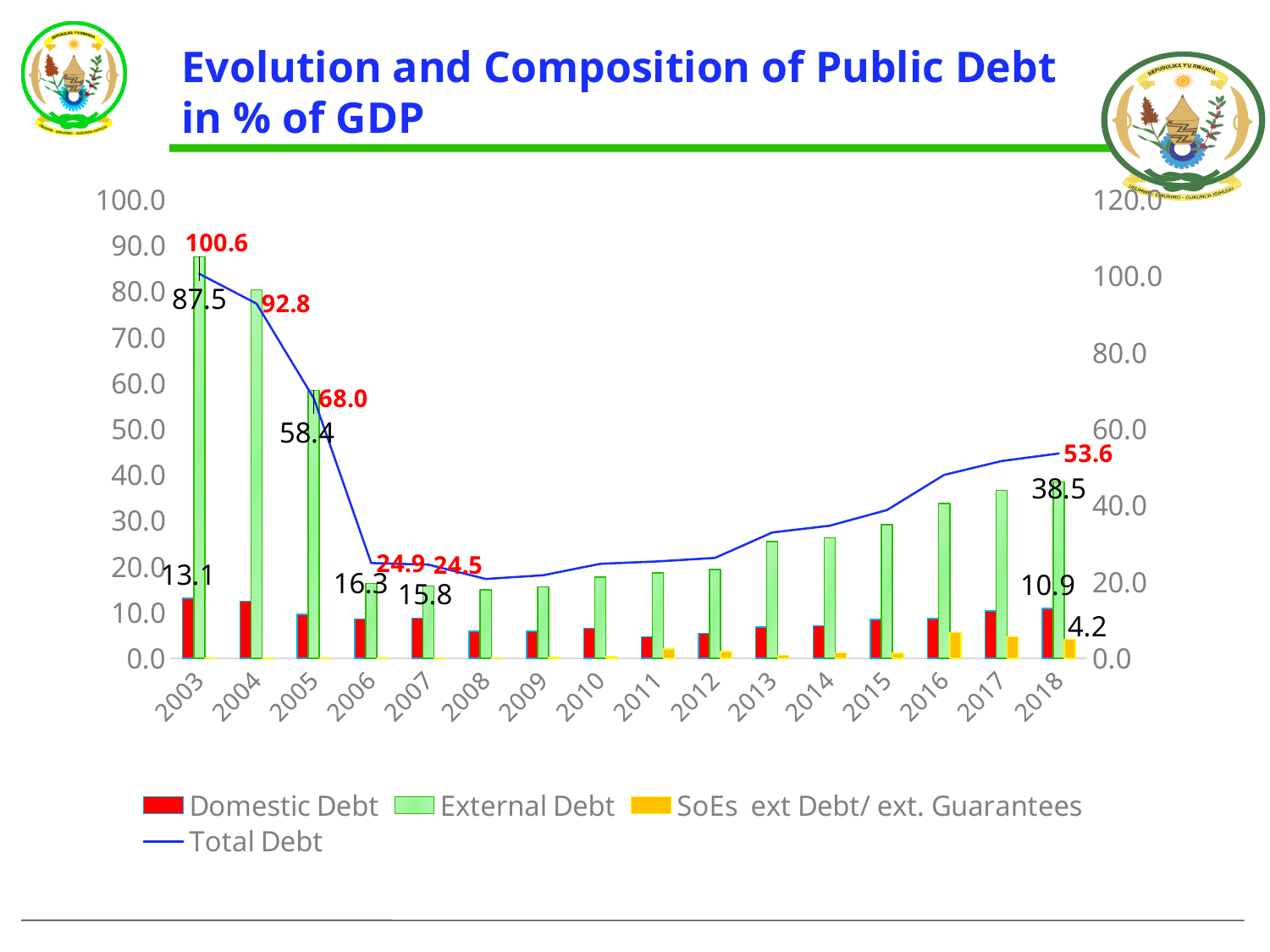
Does the Total Debt line rise or fall from 2003 to 2007? Falls What is the difference between the Total Debt in 2003 and in 2018? 47.0 How many years are shown on the x axis? 16 Is the External Debt value for 2013 greater or less than 20.0 on the left axis? greater What is the Total Debt value for 2005? 68.0 Which year has the highest Total Debt? 2003 What kind of chart is this? Combined bar and line chart What is the External Debt value for 2018? 38.5 What is the value for SoEs ext Debt/ ext. Guarantees in 2018? 4.2 What is the Domestic Debt value for 2003? 13.1 How many series does the legend list? 4 What is the Total Debt value for 2003? 100.6